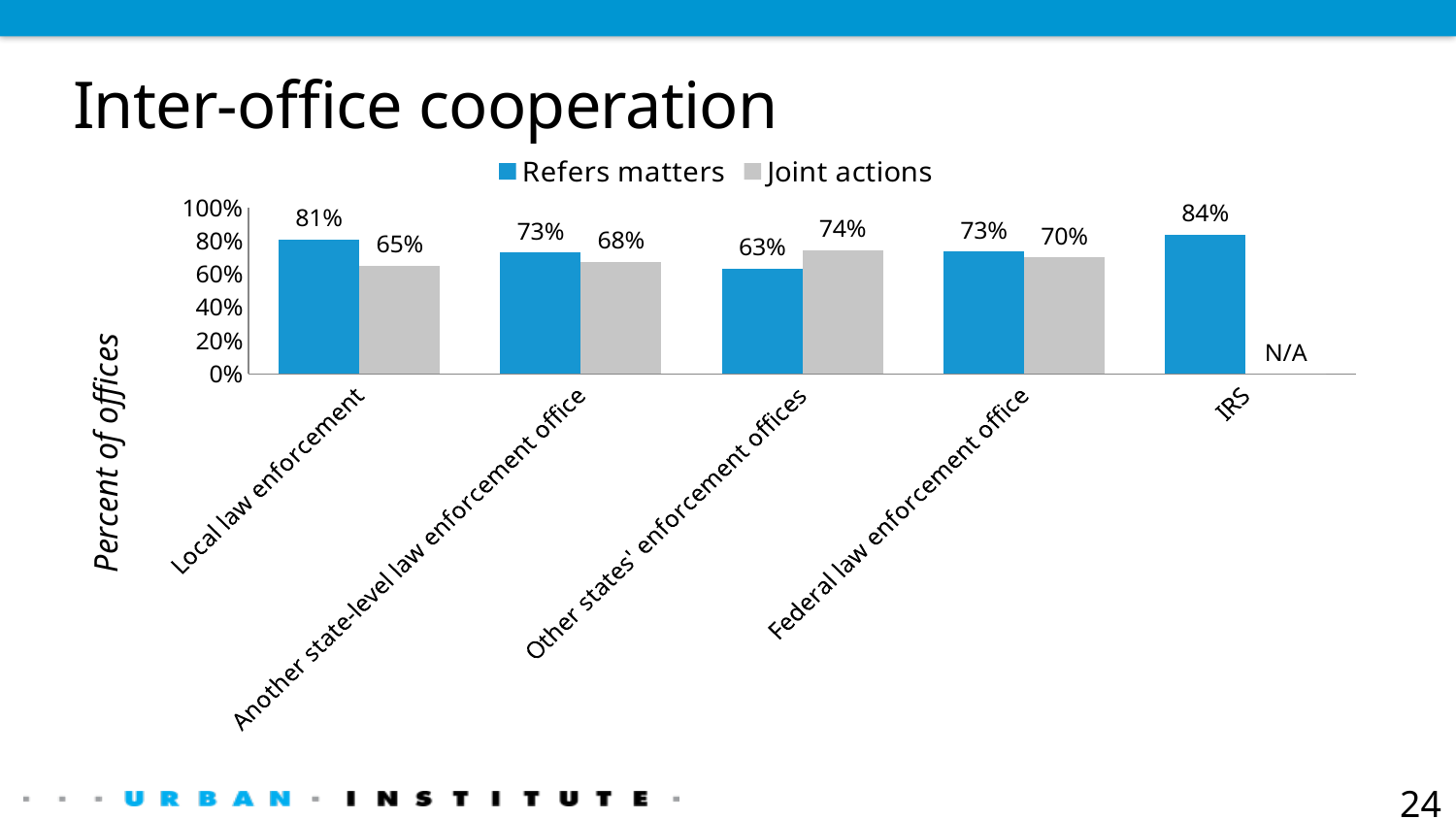
How many categories are shown on the x axis? 5 For Other states' enforcement offices, which is larger: Refers matters or Joint actions? Joint actions What kind of chart is shown on the slide? Bar chart What is the value for Joint actions for Other states' enforcement offices? 74% What is the value for Refers matters for Local law enforcement? 81% Which category has the lowest value for Refers matters? Other states' enforcement offices What is the value for Joint actions for Federal law enforcement office? 70% Which category has the lowest value for Joint actions? Local law enforcement What is shown for Joint actions for IRS? N/A How many series does the legend list? 2 Which category has the highest value for Refers matters? IRS What is the difference between Refers matters and Joint actions for Local law enforcement? 16%